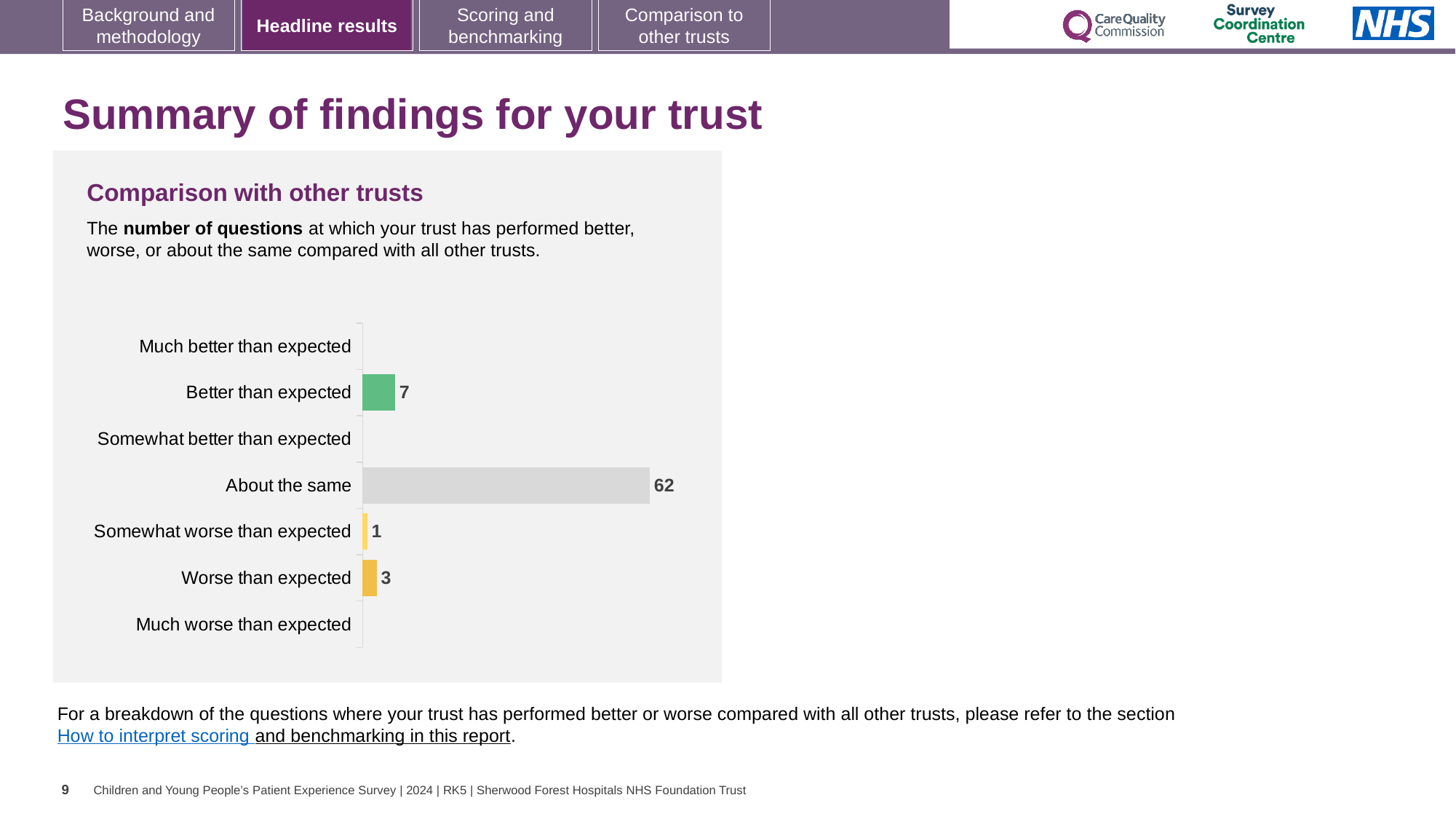
What type of chart is shown on the slide? Bar chart How many categories are listed on the chart's axis? 7 Which category has the highest number of questions? About the same How many questions were rated 'Somewhat worse than expected'? 1 How many questions were rated 'About the same'? 62 What is the title of the chart section? Comparison with other trusts What is the difference between the number of questions rated 'Better than expected' and 'Worse than expected'? 4 What is the difference between the number of questions rated 'About the same' and 'Better than expected'? 55 How many questions were rated 'Worse than expected'? 3 How many questions were rated 'Better than expected'? 7 What colour is the bar for 'Better than expected'? Green Which has more questions: 'Better than expected' or 'Worse than expected'? Better than expected